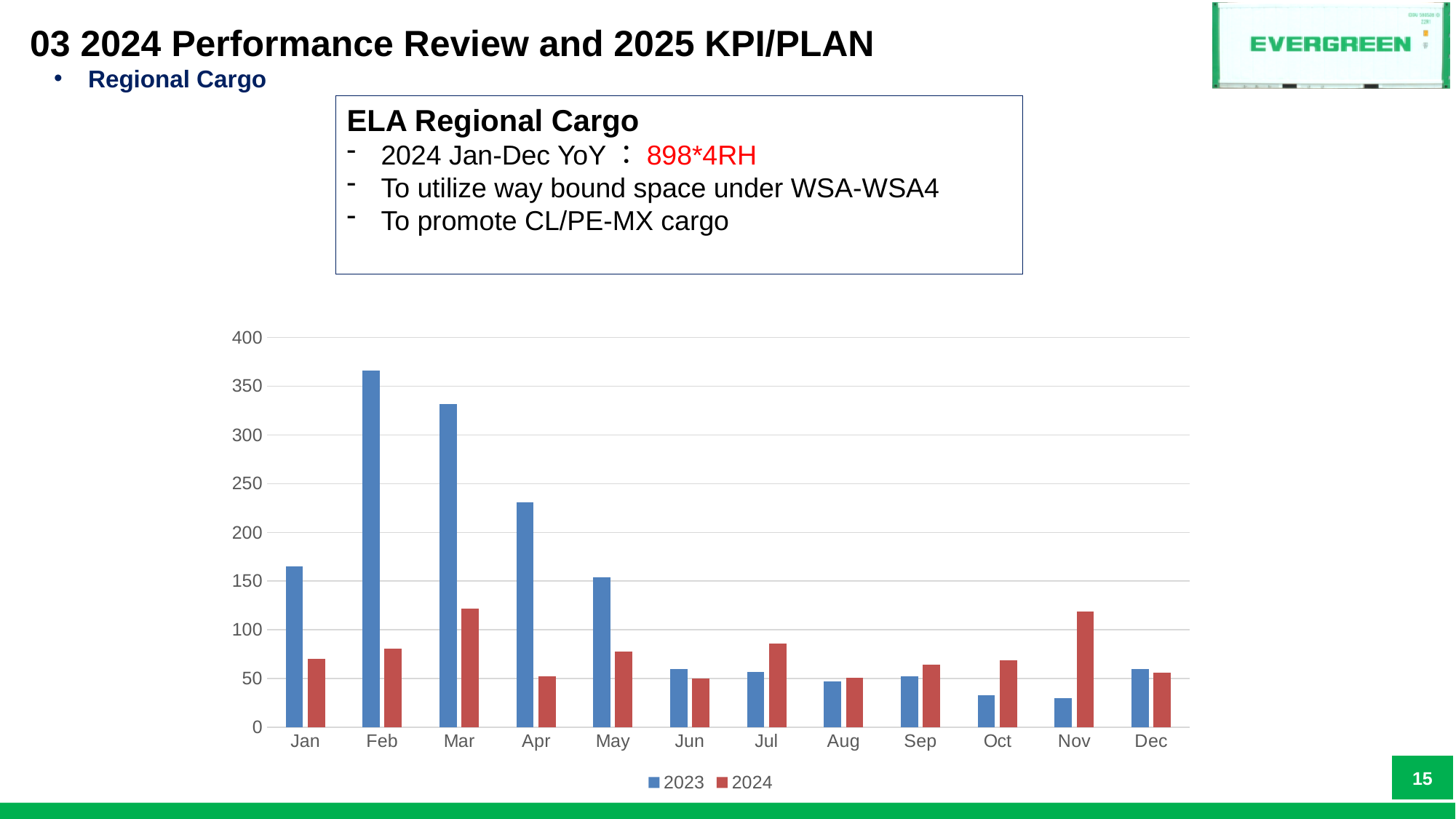
Is the 2024 value for Nov greater or less than 100? greater How many series does the chart legend list? 2 How many months are shown on the x axis of the chart? 12 From Feb to Nov, do the 2023 values generally rise or fall? fall In Nov, which series has the larger value, 2023 or 2024? 2024 Which month has the highest value for the 2023 series? Feb Which colour represents the 2024 series in the chart? red What kind of chart is shown on the slide? bar chart Is the 2023 value for Feb greater or less than 350? greater Is the 2023 value for Mar greater or less than 300? greater In Feb, which series has the larger value, 2023 or 2024? 2023